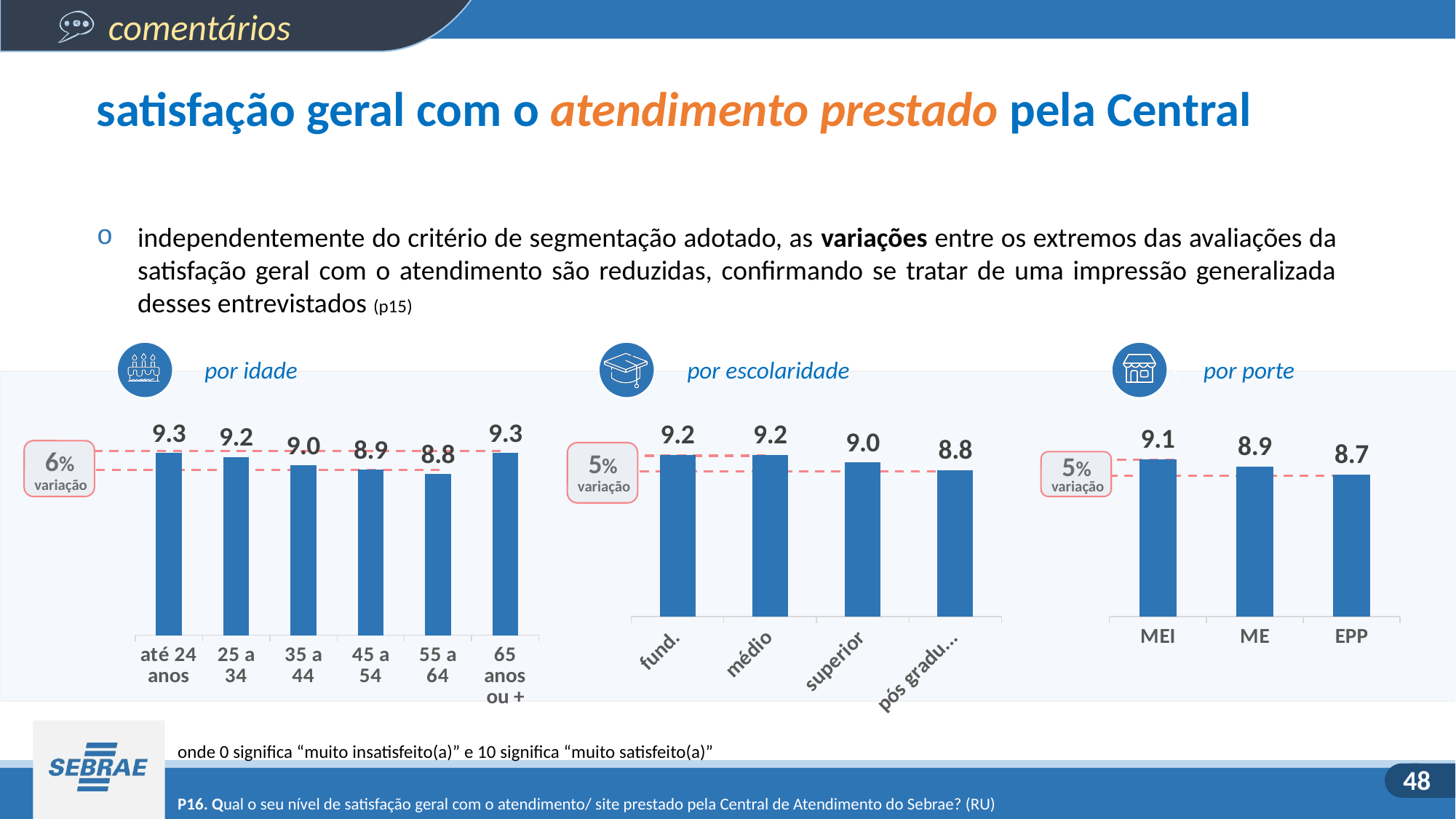
In the 'por porte' chart, what is the value for ME? 8.9 In the 'por idade' chart, which age group has the lowest value? 55 a 64 What kind of chart is the 'por porte' chart? bar chart In the 'por idade' chart, what is the value for 35 a 44? 9.0 In the 'por escolaridade' chart, which is larger, the value for médio or the value for superior? médio In the 'por porte' chart, do the values rise or fall from MEI to EPP? fall In the 'por porte' chart, what is the difference between the values for MEI and EPP? 0.4 In the 'por idade' chart, how many age categories are shown? 6 In the 'por escolaridade' chart, what is the value for superior? 9.0 In the 'por idade' chart, what is the difference between the values for até 24 anos and 55 a 64? 0.5 In the 'por escolaridade' chart, how many categories are shown? 4 In the 'por porte' chart, which category has the highest value? MEI